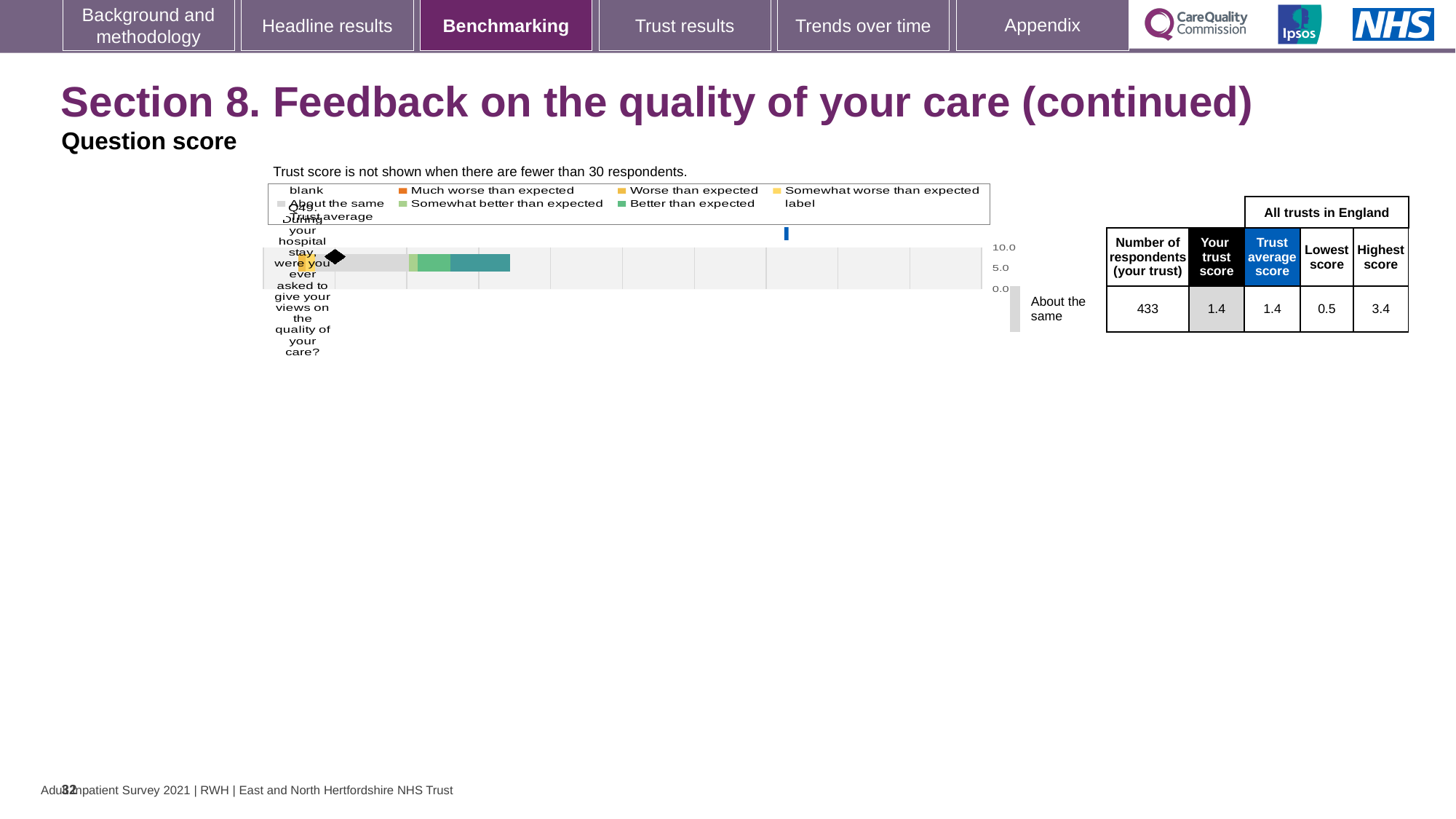
How many survey questions are plotted in the benchmarking chart? 1 Which question number is plotted in the benchmarking chart? Q49 What kind of chart is used to show the Q49 benchmarking result? bar chart According to the table beside the chart, what is the trust score for Q49? 1.4 According to the table beside the chart, how many respondents answered Q49 for this trust? 433 According to the table beside the chart, what is the trust average score for Q49? 1.4 According to the table beside the chart, what is the lowest score among all trusts in England for Q49? 0.5 According to the table beside the chart, what is the highest score among all trusts in England for Q49? 3.4 Which is larger for Q49 in the table beside the chart: the highest score or the trust score? highest score What is the difference between the highest and lowest scores for Q49 shown in the table beside the chart? 2.9 What benchmark category is shown for Q49 next to the chart? About the same Which colour in the chart legend represents 'Much worse than expected'? orange